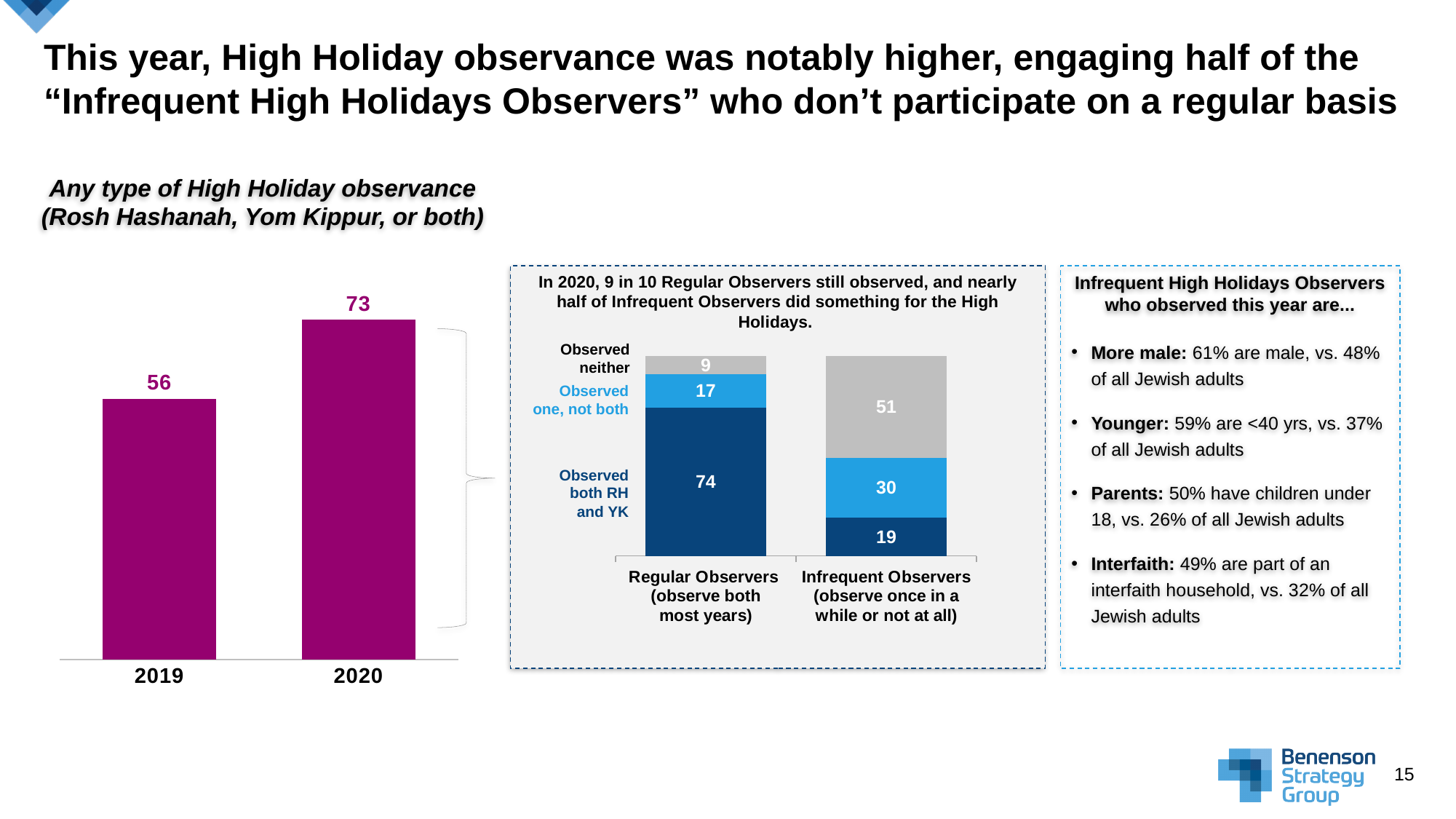
In the left chart 'Any type of High Holiday observance', what is the value for 2020? 73 In the left chart 'Any type of High Holiday observance', do the values rise or fall from 2019 to 2020? rise In the middle stacked bar chart, what is the 'Observed neither' value for Infrequent Observers? 51 In the left chart 'Any type of High Holiday observance', what is the difference between the 2020 and 2019 values? 17 In the middle stacked bar chart, what is the difference between the 'Observed neither' values for Infrequent Observers and Regular Observers? 42 In the middle stacked bar chart, which group has the larger 'Observed both RH and YK' value, Regular Observers or Infrequent Observers? Regular Observers What kind of chart is the left chart 'Any type of High Holiday observance'? bar chart In the left chart 'Any type of High Holiday observance', what is the value for 2019? 56 In the middle stacked bar chart, what is the 'Observed both RH and YK' value for Regular Observers? 74 In the middle stacked bar chart, what is the 'Observed one, not both' value for Infrequent Observers? 30 In the left chart 'Any type of High Holiday observance', how many bars are plotted? 2 In the middle stacked bar chart, how many segments (series) make up each stacked bar? 3